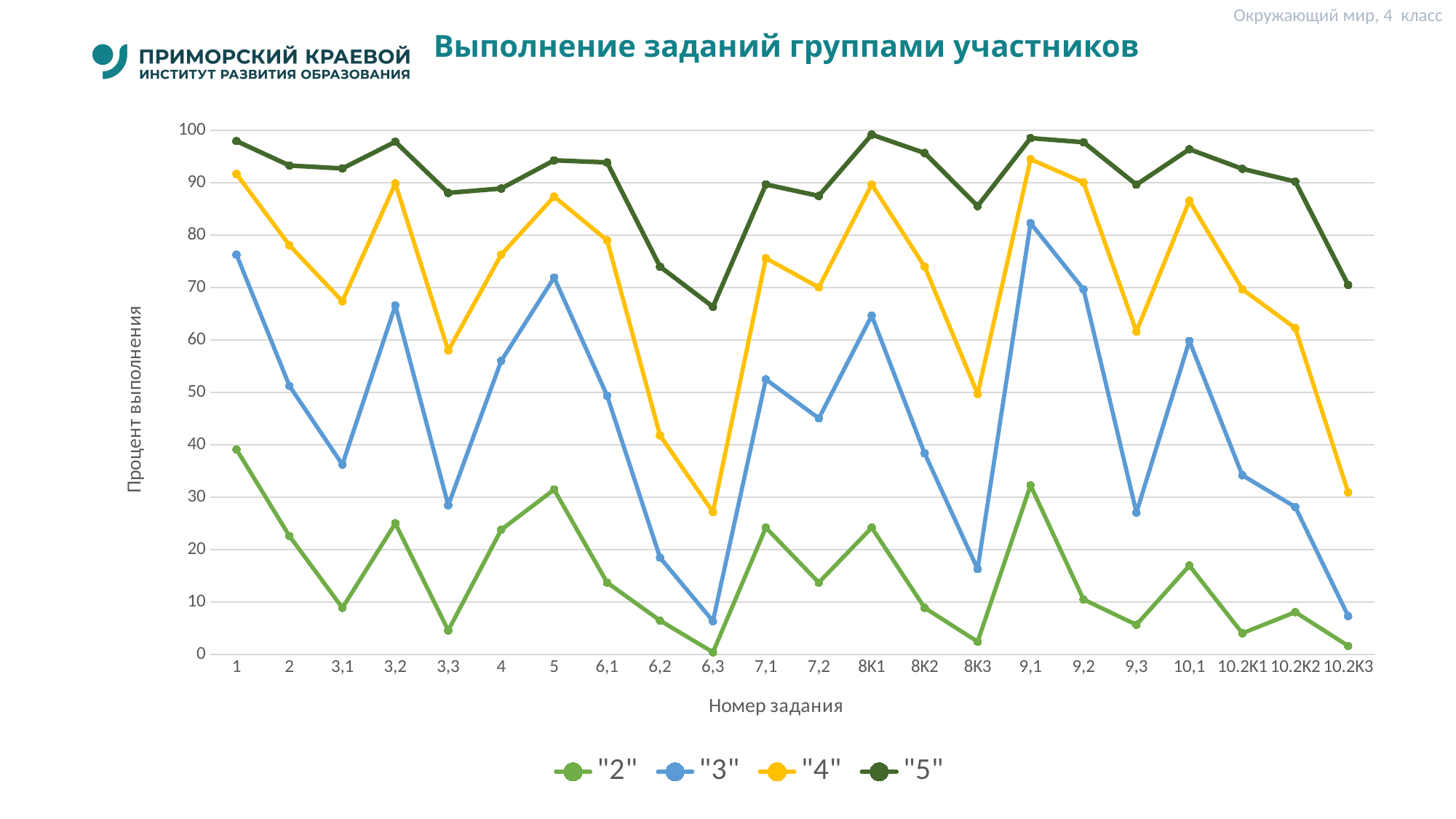
How many task numbers are shown along the x axis? 22 What is the title of the chart? Выполнение заданий группами участников How many series does the legend list? 4 What kind of chart is shown on the slide? line chart For series "3", at which task number is the value highest? 9,1 Is the value for series "3" at task 9,1 greater or less than 70? greater Is the value for series "5" at task 8К1 greater or less than 90? greater At task 6,3, which series has the larger value, "4" or "3"? "4" Is the value for series "4" at task 10.2К3 greater or less than 40? less For series "2", at which task number is the value highest? 1 Do the values for series "5" rise or fall from task 10.2К1 to task 10.2К3? fall